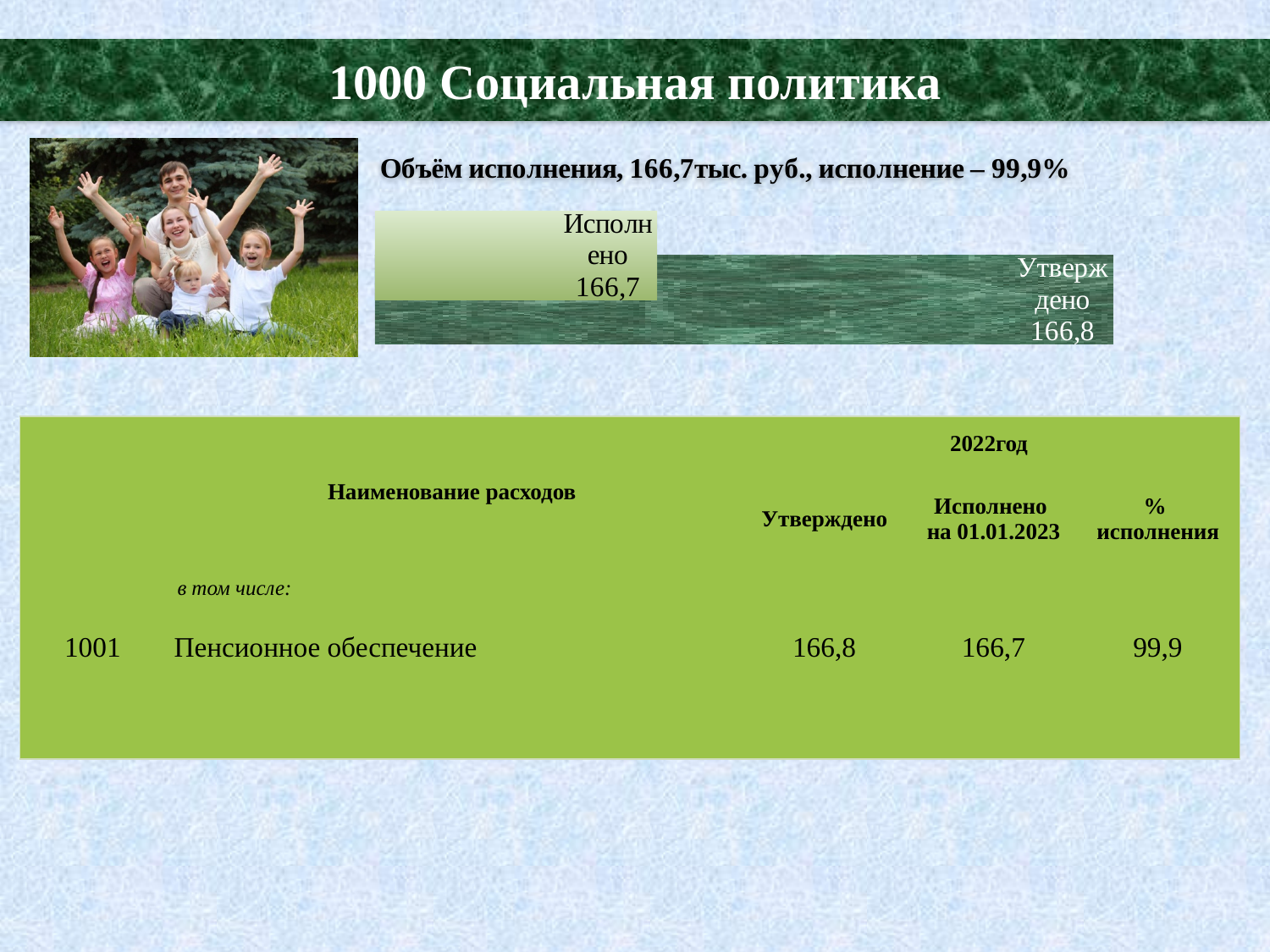
What are the labels of the two bars in the chart? Исполнено and Утверждено What kind of chart is shown on the slide? bar chart What is the difference between the Утверждено and Исполнено values in the chart? 0,1 What is the value of the bar labelled Утверждено in the chart? 166,8 Which bar in the chart shows the highest value? Утверждено Is the value of the Исполнено bar greater or less than 100? greater Which bar in the chart is drawn in the darker green colour? Утверждено Which bar in the chart shows the lowest value? Исполнено What is the value of the bar labelled Исполнено in the chart? 166,7 How many bars does the chart contain? 2 Which bar in the chart has the larger value, Утверждено or Исполнено? Утверждено